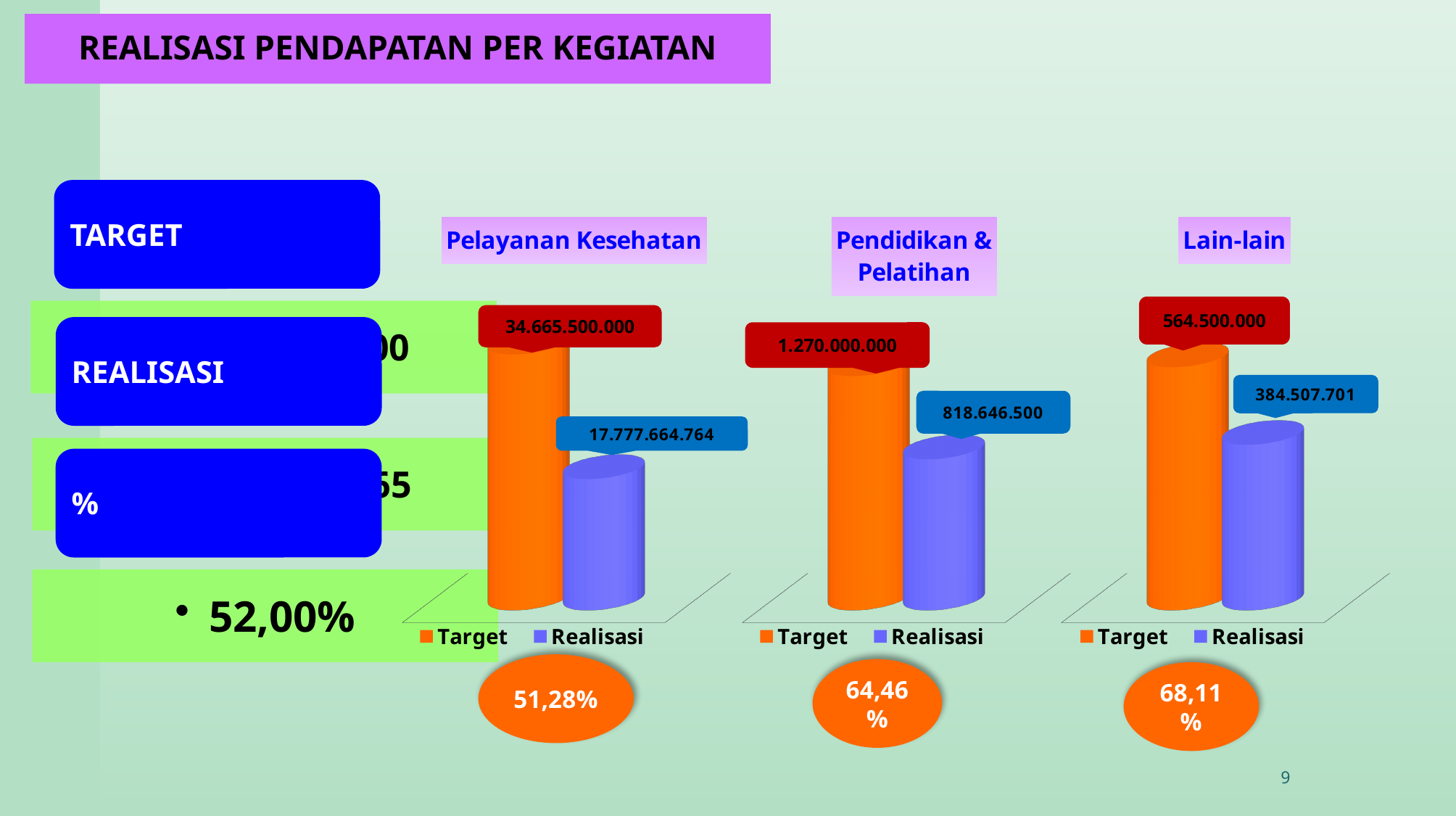
In the Pelayanan Kesehatan chart, what colour is the Target bar? Orange What type of chart is the Pendidikan & Pelatihan chart? Bar chart In the Lain-lain chart, what is the value of the Realisasi bar? 384.507.701 In the Pelayanan Kesehatan chart, what is the value of the Target bar? 34.665.500.000 In the Pelayanan Kesehatan chart, what is the value of the Realisasi bar? 17.777.664.764 In the Pendidikan & Pelatihan chart, what is the difference between the Target and Realisasi values? 451.353.500 In the Pendidikan & Pelatihan chart, what is the value of the Target bar? 1.270.000.000 In the Lain-lain chart, what is the difference between the Target and Realisasi values? 179.992.299 How many series does the legend of the Lain-lain chart list? 2 In the Pendidikan & Pelatihan chart, what is the value of the Realisasi bar? 818.646.500 In the Lain-lain chart, what is the value of the Target bar? 564.500.000 In the Pelayanan Kesehatan chart, which series is larger, Target or Realisasi? Target